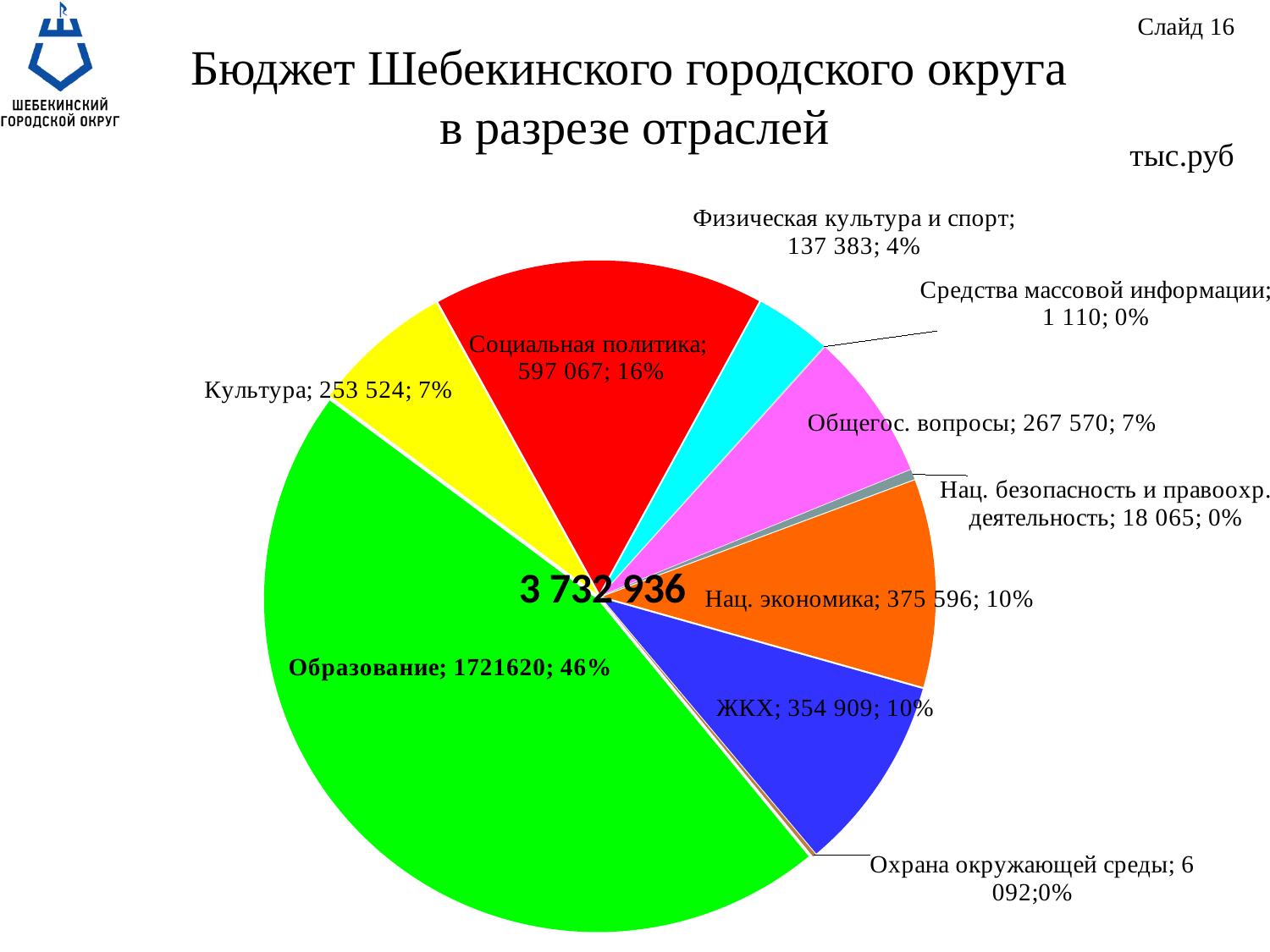
How many categories are shown in the pie chart? 10 What is the value for Нац. безопасность и правоохр. деятельность? 18 065 What type of chart is shown on the slide? pie chart Which is larger, the value for Нац. экономика or the value for ЖКХ? Нац. экономика What is the difference between the values for Социальная политика and Культура? 343 543 What is the value for Образование? 1721620 Which category has the smallest value? Средства массовой информации Which category has the largest slice of the pie? Образование What is the value for Социальная политика? 597 067 What share of the pie does Социальная политика represent? 16% What is the value for ЖКХ? 354 909 What share of the pie does Культура represent? 7%